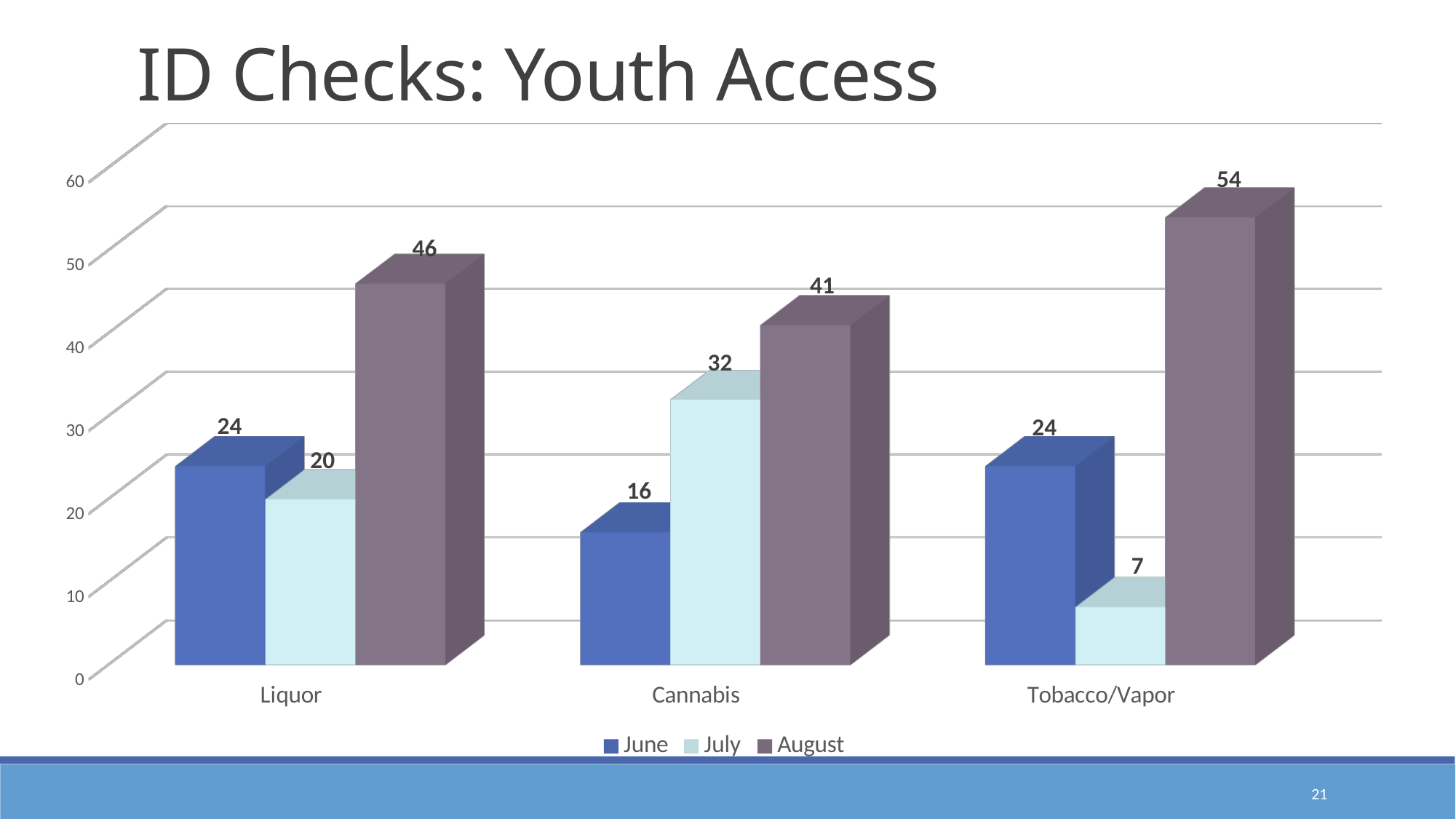
Which is larger, the July value for Cannabis or the July value for Liquor? Cannabis Do the values for Cannabis rise or fall from June to August? Rise Which category has the highest August value? Tobacco/Vapor How many categories are shown on the x axis? 3 Which category has the lowest July value? Tobacco/Vapor What kind of chart is shown on the slide? Bar chart What is the title of the slide? ID Checks: Youth Access How many series does the legend list? 3 What is the difference between the August and June values for Liquor? 22 What is the value for Tobacco/Vapor in August? 54 What is the value for Liquor in June? 24 What is the value for Cannabis in July? 32